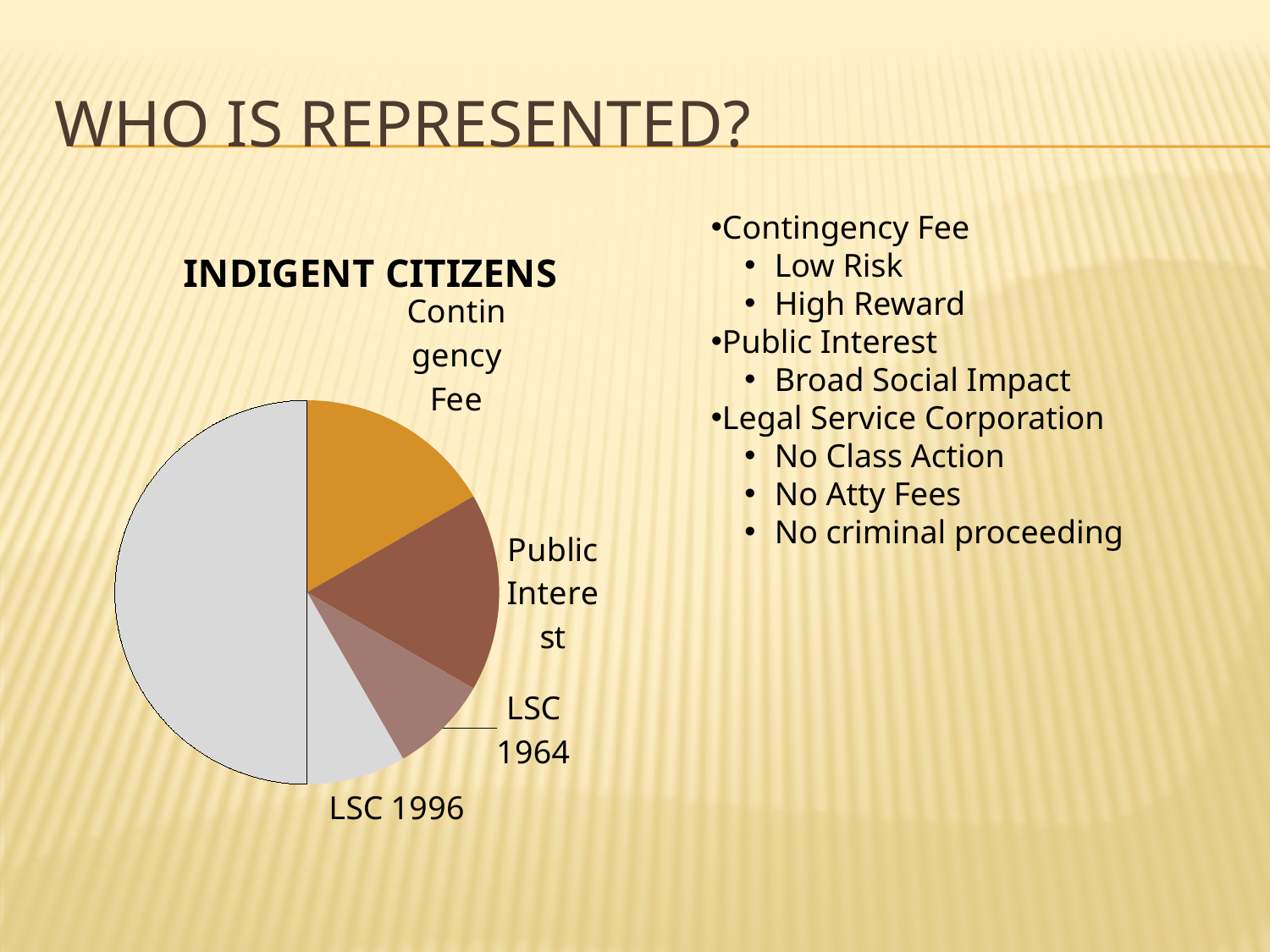
What kind of chart is shown on the slide? pie chart Which is larger in the pie chart, the Public Interest slice or the LSC 1964 slice? Public Interest Which is larger in the pie chart, the Contingency Fee slice or the LSC 1964 slice? Contingency Fee How many labeled slices does the pie chart have? 4 What is the title of the pie chart? INDIGENT CITIZENS What colour is the Contingency Fee slice in the pie chart? orange